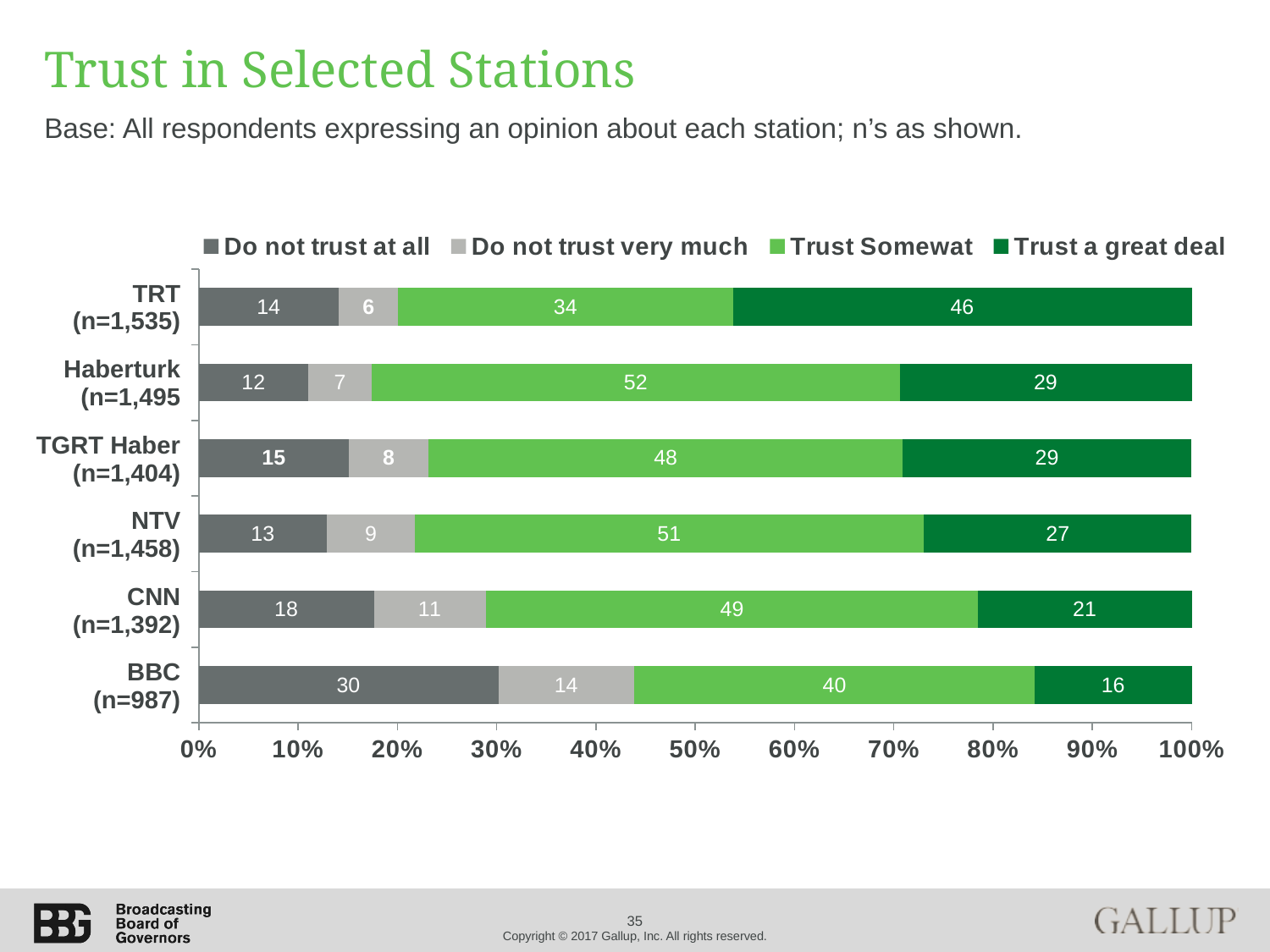
What is the difference between the 'Trust a great deal' values for TRT and NTV? 19 What is the 'Do not trust at all' value for BBC? 30 Which station has the highest 'Do not trust at all' value? BBC Which station has the lowest 'Trust a great deal' value? BBC What is the 'Trust a great deal' value for TRT? 46 How many stations are shown in the chart? 6 What is the 'Do not trust very much' value for CNN? 11 Which station has the highest 'Trust a great deal' value? TRT What kind of chart is shown on the slide? Stacked bar chart What is the 'Trust Somewat' value for Haberturk? 52 Which is larger: the 'Trust Somewat' value for NTV or for BBC? NTV How many series does the legend list? 4